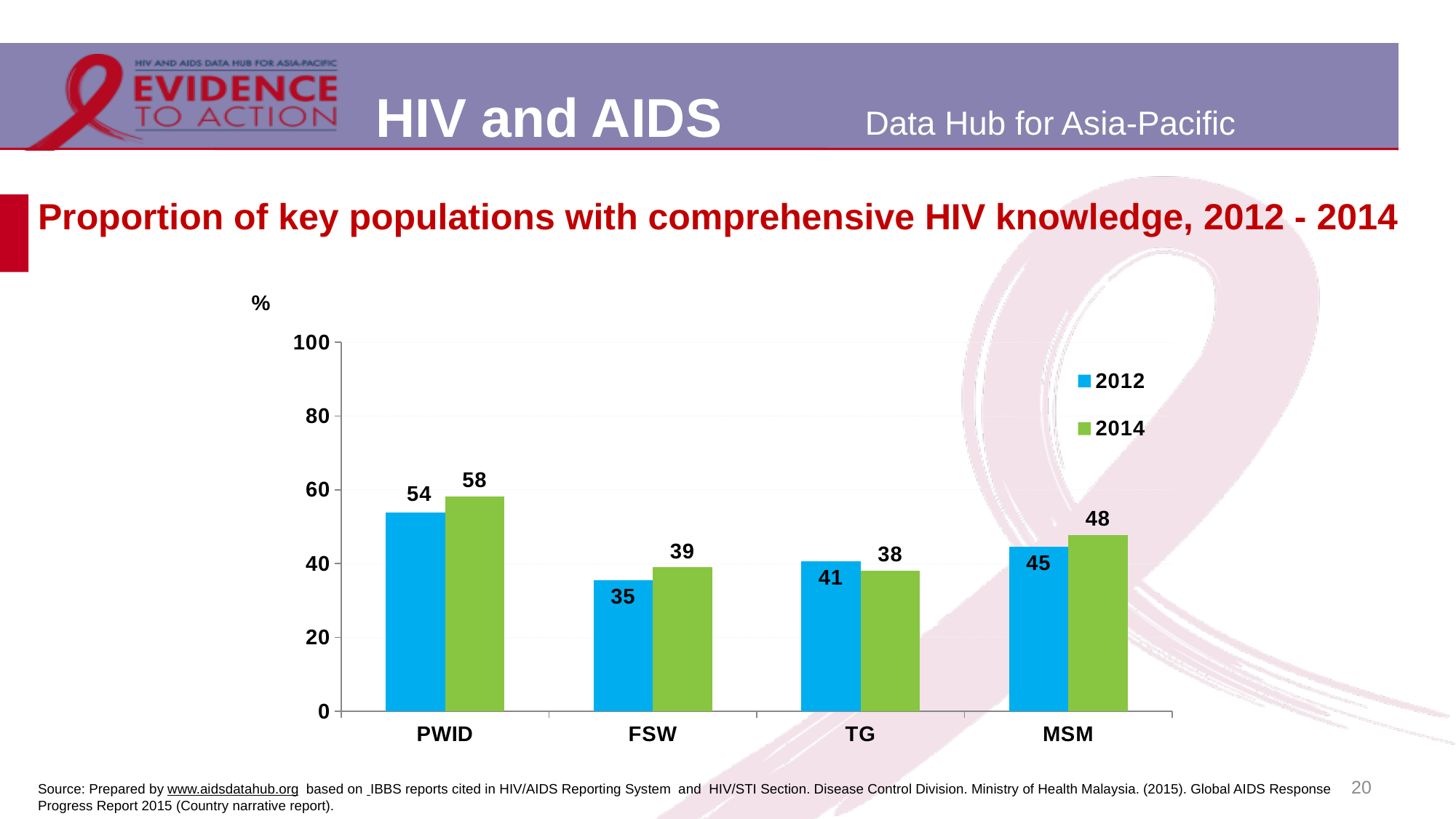
Which key population has the lowest value in 2012? FSW Which colour represents 2014 in the legend? green What kind of chart is shown on the slide? bar chart Which key population has the highest value in 2014? PWID Which is larger for TG: the 2012 value or the 2014 value? 2012 What is the value for MSM in 2014? 48 Is the 2014 value for MSM greater or less than 40? greater What is the value for PWID in 2012? 54 What is the difference between the 2014 and 2012 values for PWID? 4 What is the value for FSW in 2012? 35 How many key populations are shown on the x axis? 4 How many series does the legend list? 2